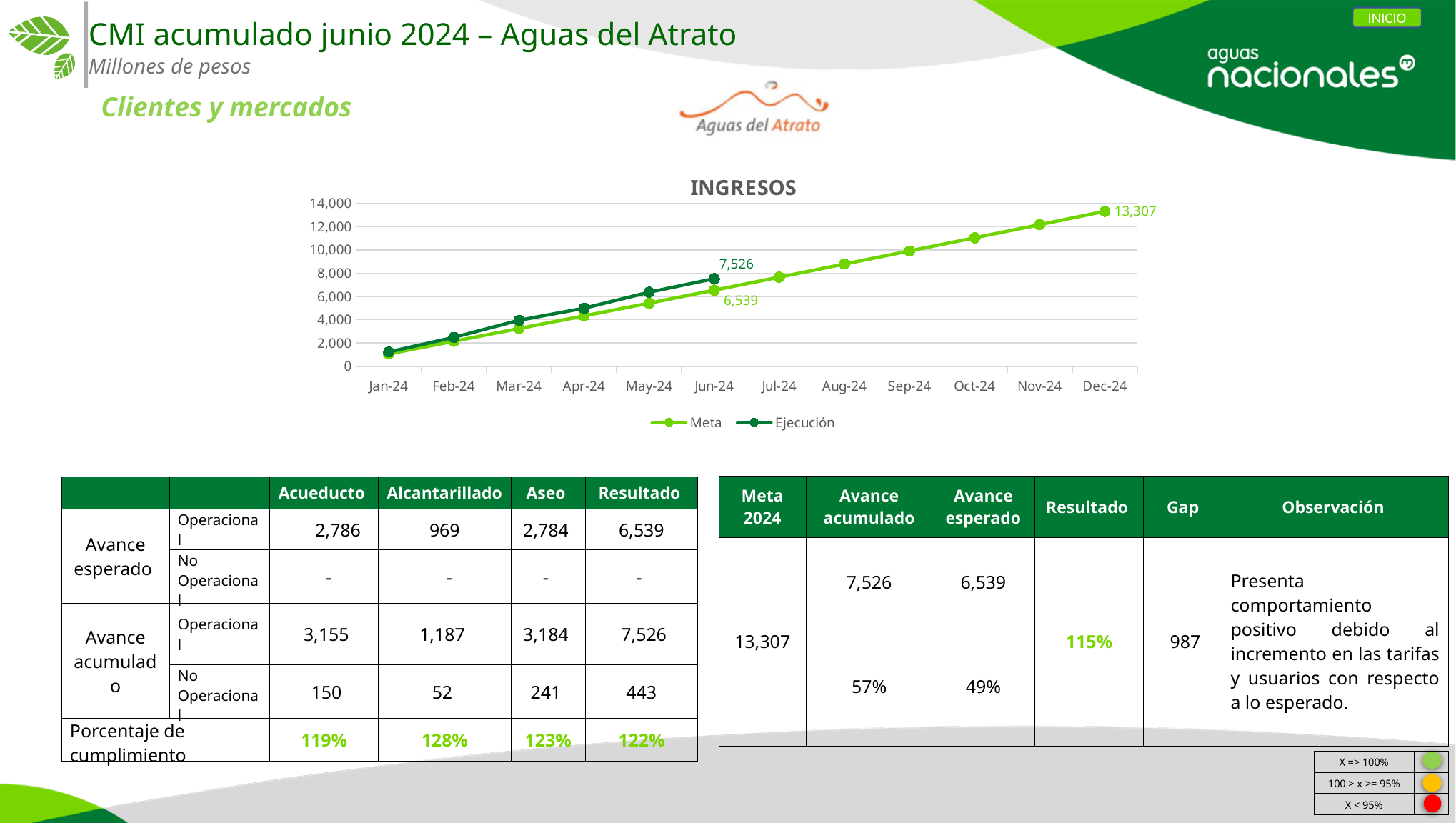
Does the Meta line in the INGRESOS chart rise or fall from Jan-24 to Dec-24? rise In the INGRESOS chart, what is the difference between the Ejecución and Meta values for Jun-24? 987 What kind of chart is the INGRESOS chart? line chart In the INGRESOS chart, which series has the higher value at Jun-24, Meta or Ejecución? Ejecución What is the Meta value for Jun-24 in the INGRESOS chart? 6,539 What is the Meta value for Dec-24 in the INGRESOS chart? 13,307 What is the Ejecución value for Jun-24 in the INGRESOS chart? 7,526 In the INGRESOS chart, is the Ejecución value for Apr-24 greater or less than 4,000? greater In the INGRESOS chart, is the Meta value for Oct-24 greater or less than 10,000? greater How many series does the legend of the INGRESOS chart list? 2 How many months are shown on the x axis of the INGRESOS chart? 12 What are the two series named in the legend of the INGRESOS chart? Meta and Ejecución